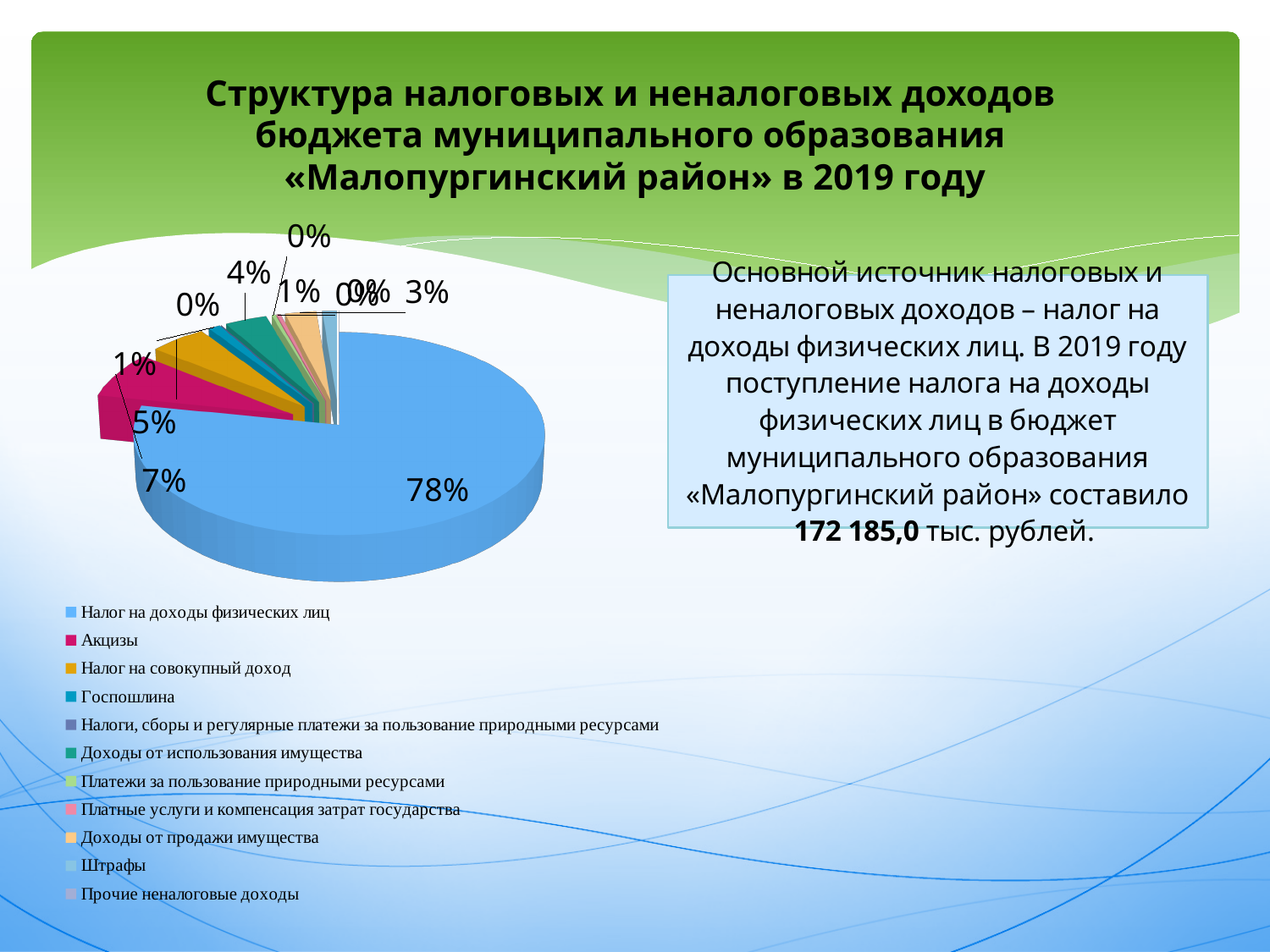
What share of the pie does "Налог на совокупный доход" have? 5% What is the title of the slide containing the pie chart? Структура налоговых и неналоговых доходов бюджета муниципального образования «Малопургинский район» в 2019 году Which category has the largest slice of the pie? Налог на доходы физических лиц Which is larger, the slice for "Акцизы" or the slice for "Налог на совокупный доход"? Акцизы Which legend category is shown in magenta/pink-red in the pie chart? Акцизы How many categories does the legend of the pie chart list? 11 What kind of chart is shown on the slide? pie chart What share of the pie does "Акцизы" have? 7% What share of the pie does "Налог на доходы физических лиц" have? 78% What is the difference in percentage points between the "Налог на доходы физических лиц" slice and the "Акцизы" slice? 71 percentage points Is the share for "Налог на доходы физических лиц" greater or less than 50%? greater